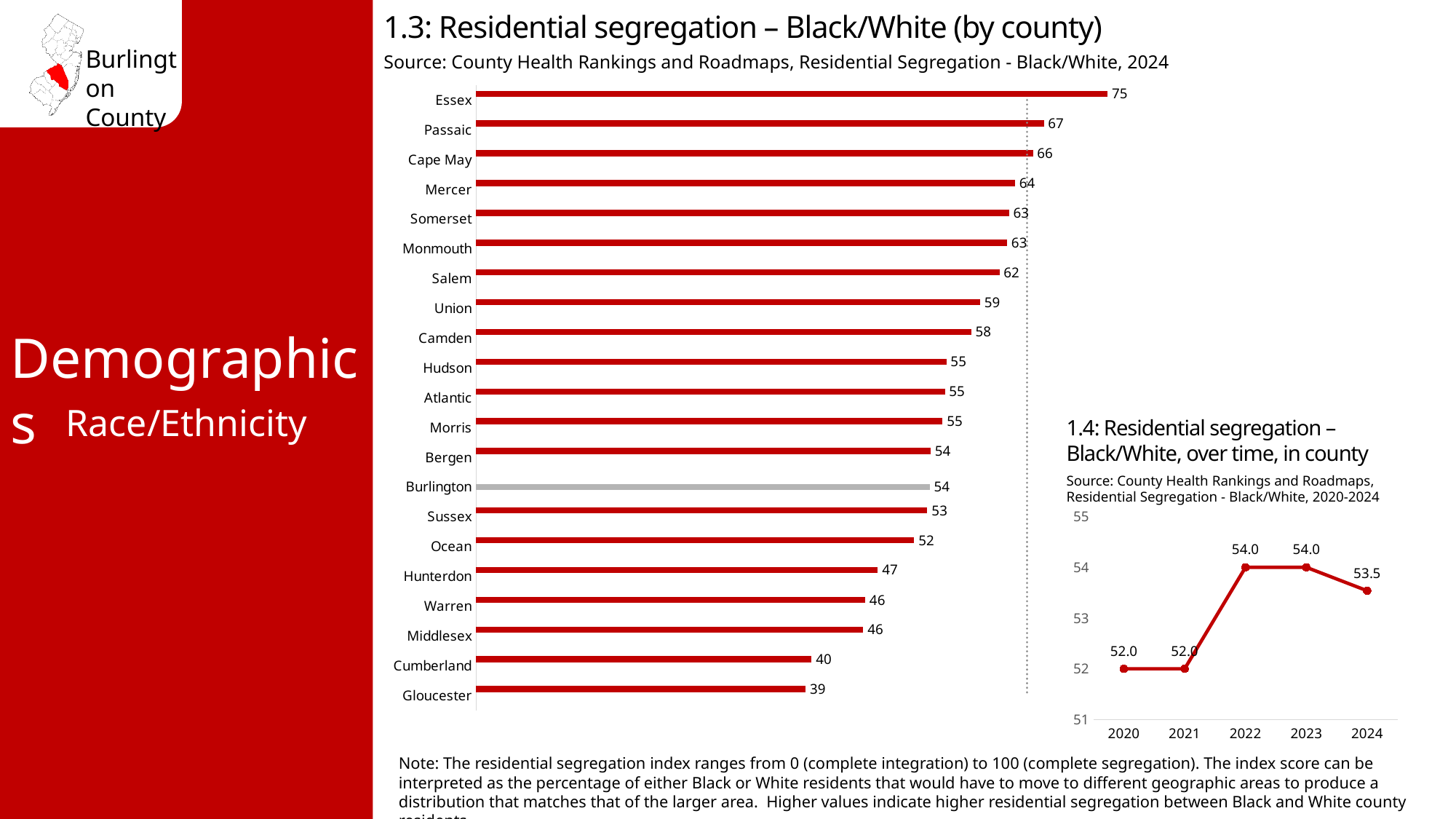
In the chart '1.3: Residential segregation – Black/White (by county)', which county has the highest value? Essex What kind of chart is '1.3: Residential segregation – Black/White (by county)'? Bar chart In the chart '1.3: Residential segregation – Black/White (by county)', what is the difference between the values for Essex and Gloucester? 36 In the chart '1.3: Residential segregation – Black/White (by county)', what is the value for Burlington? 54 In the chart '1.3: Residential segregation – Black/White (by county)', which county has the lowest value? Gloucester In the chart '1.4: Residential segregation – Black/White, over time, in county', what is the difference between the values for 2022 and 2020? 2.0 In the chart '1.3: Residential segregation – Black/White (by county)', how many counties are shown? 21 In the chart '1.4: Residential segregation – Black/White, over time, in county', what is the value for 2024? 53.5 In the chart '1.3: Residential segregation – Black/White (by county)', which has a larger value, Passaic or Camden? Passaic What kind of chart is '1.4: Residential segregation – Black/White, over time, in county'? Line chart In the chart '1.3: Residential segregation – Black/White (by county)', what is the value for Cumberland? 40 In the chart '1.4: Residential segregation – Black/White, over time, in county', how many years are plotted? 5